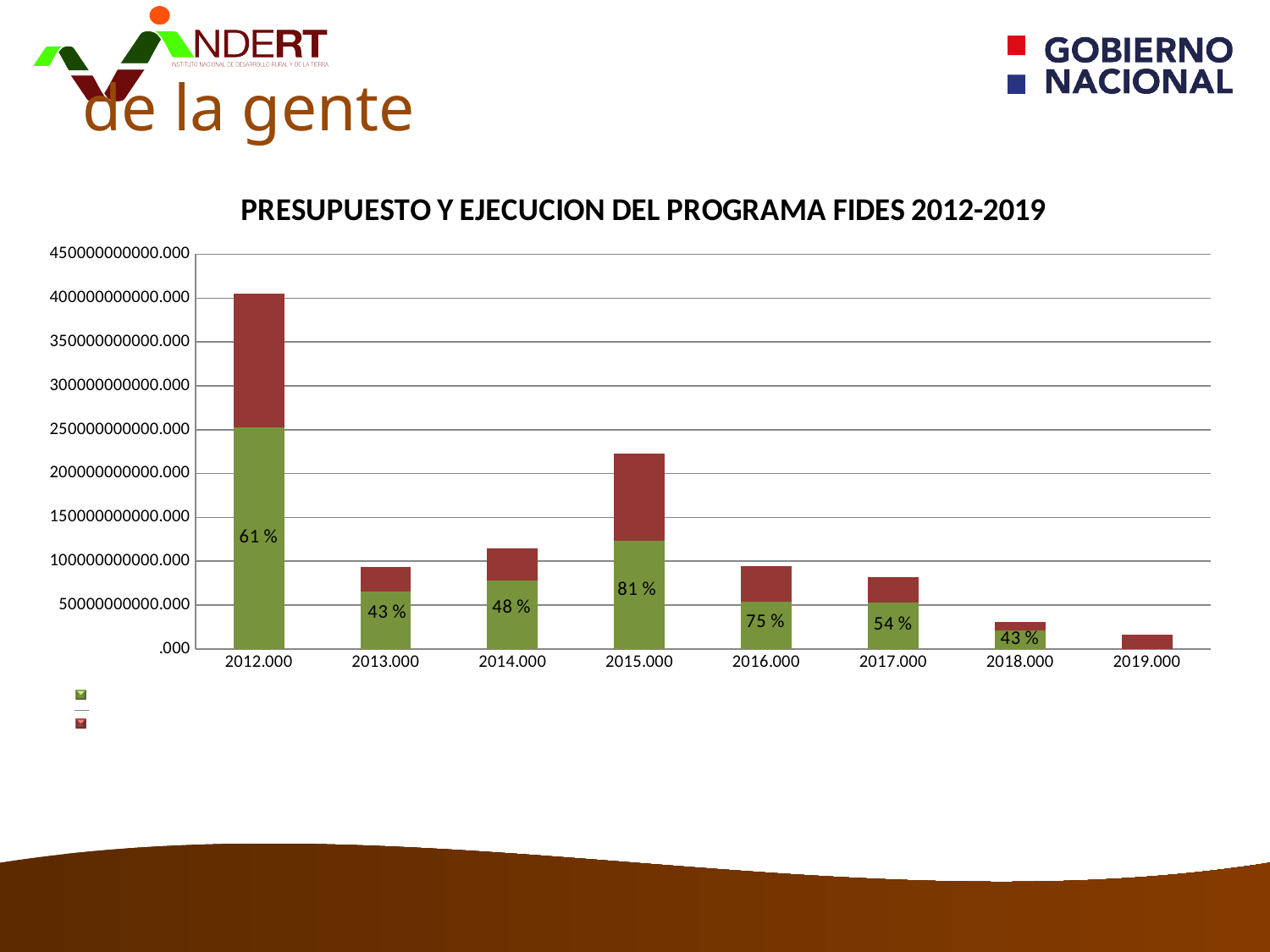
Which year has the tallest stacked bar overall? 2012.000 What percentage label is shown on the bar for 2012.000? 61 % What percentage label is shown on the bar for 2015.000? 81 % Which year has the highest percentage label on its bar? 2015.000 What kind of chart is shown on the slide? bar chart Which year has the shortest stacked bar overall? 2019.000 What percentage label is shown on the bar for 2016.000? 75 % What is the title of the chart? PRESUPUESTO Y EJECUCION DEL PROGRAMA FIDES 2012-2019 How many years (categories) are shown along the x axis of the chart? 8 Is the total height of the stacked bar for 2013.000 greater or less than 100000000000.000? less Is the total height of the stacked bar for 2015.000 greater or less than 200000000000.000? greater